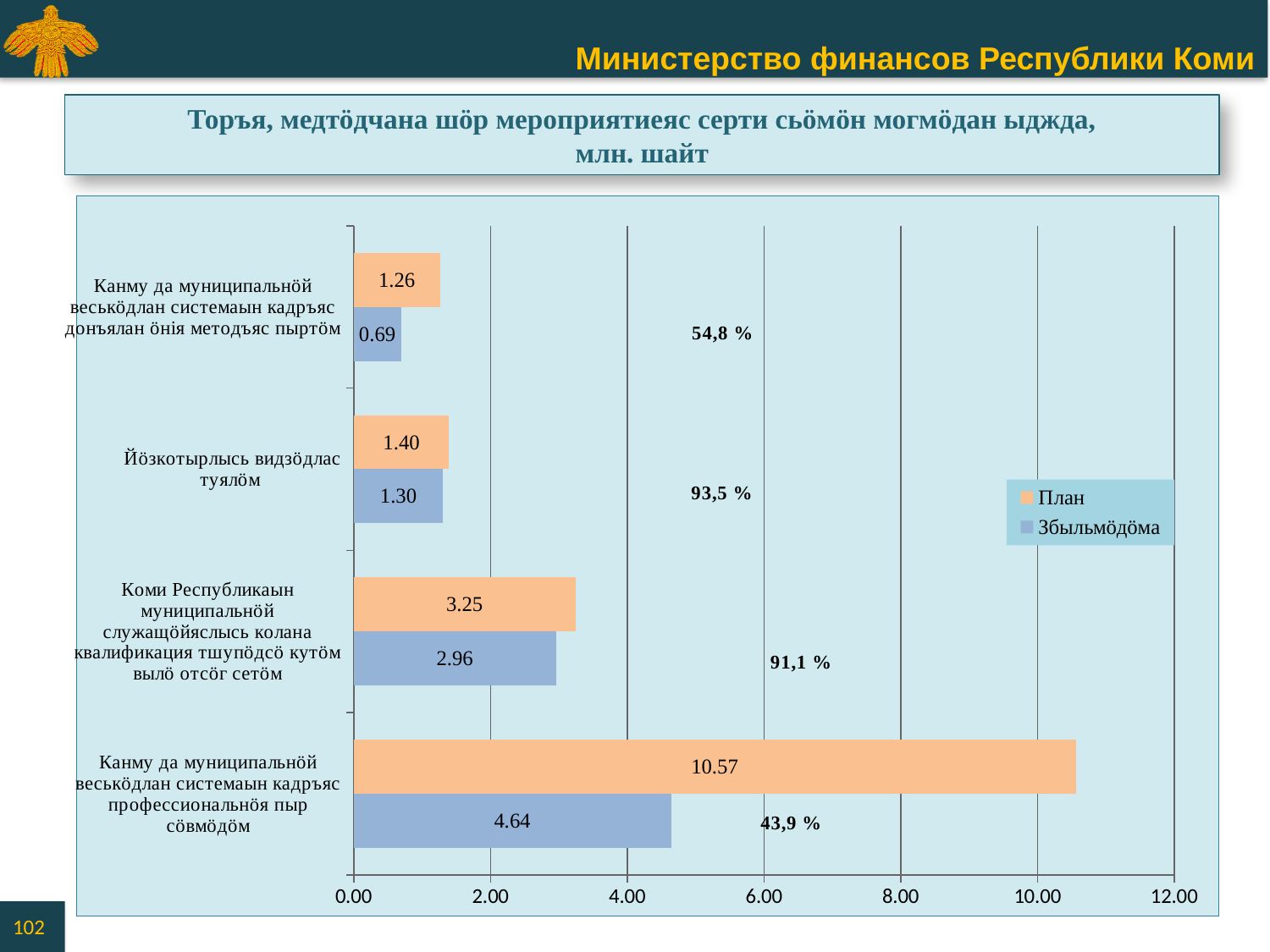
How many series does the legend list? 2 How many categories are plotted on the chart? 4 What is the Збыльмӧдӧма value for "Коми Республикаын муниципальнӧй служащӧйяслысь колана квалификация тшупӧдсӧ кутӧм вылӧ отсӧг сетӧм"? 2.96 Which category has the highest План value? Канму да муниципальнӧй веськӧдлан системаын кадръяс профессиональнӧя пыр сӧвмӧдӧм What is the Збыльмӧдӧма value for "Йӧзкотырлысь видзӧдлас туялӧм"? 1.30 What percentage label is shown next to the bars for "Йӧзкотырлысь видзӧдлас туялӧм"? 93,5 % Which is larger for "Канму да муниципальнӧй веськӧдлан системаын кадръяс донъялан ӧнія методъяс пыртӧм": the План value or the Збыльмӧдӧма value? План What is the План value for "Йӧзкотырлысь видзӧдлас туялӧм"? 1.40 Which category has the lowest Збыльмӧдӧма value? Канму да муниципальнӧй веськӧдлан системаын кадръяс донъялан ӧнія методъяс пыртӧм What type of chart is shown on the slide? bar chart What is the План value for "Канму да муниципальнӧй веськӧдлан системаын кадръяс профессиональнӧя пыр сӧвмӧдӧм"? 10.57 What is the difference between the План and Збыльмӧдӧма values for "Канму да муниципальнӧй веськӧдлан системаын кадръяс профессиональнӧя пыр сӧвмӧдӧм"? 5.93